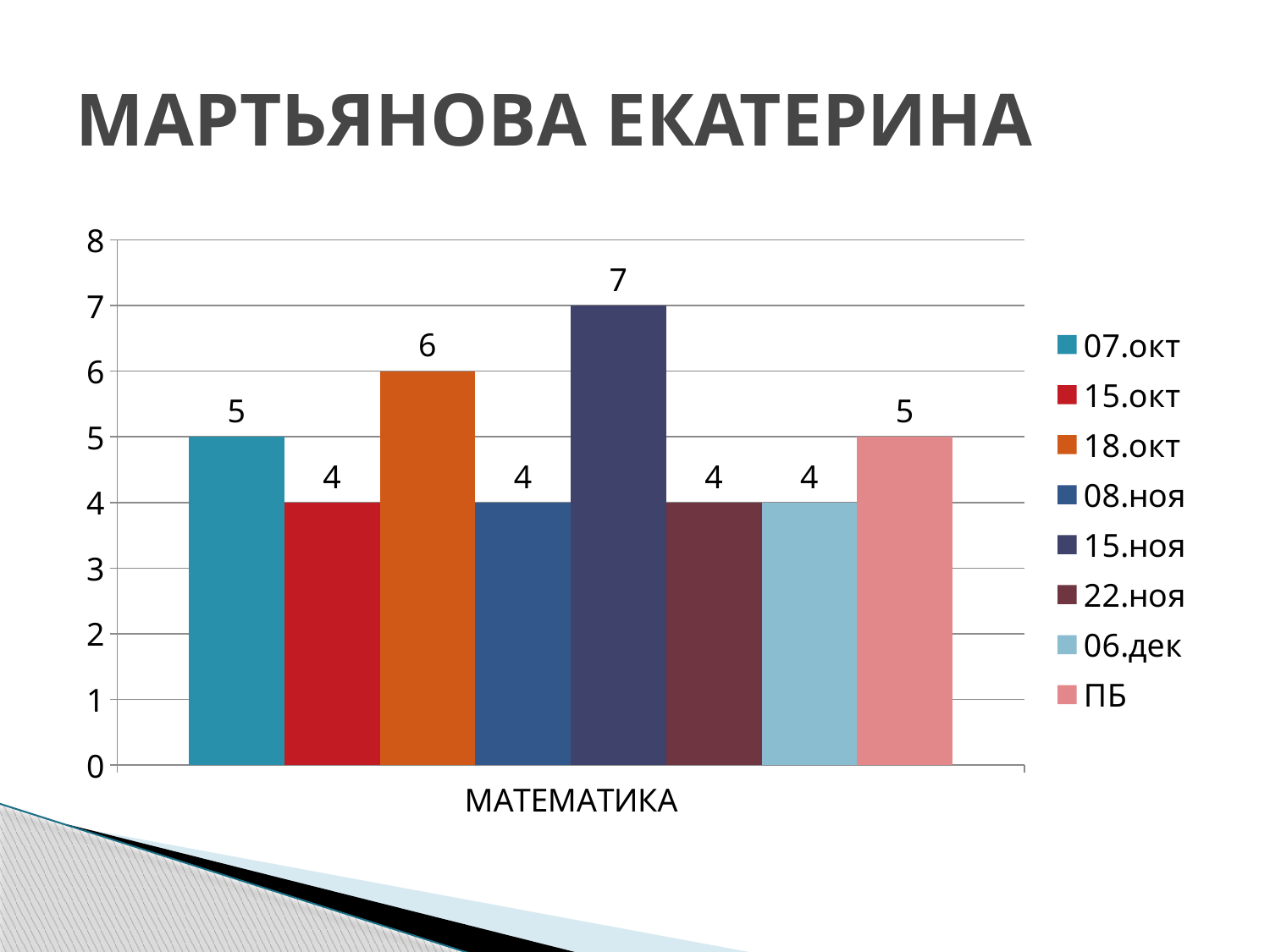
What is the difference between the 15.ноя value and the 18.окт value? 1 What is the difference between the 15.ноя value and the 15.окт value? 3 Which series has the highest value? 15.ноя How many series does the legend list? 8 Which is larger, the value for 07.окт or the value for 18.окт? 18.окт How many series have a value of 4? 4 What is the category label shown on the x axis? МАТЕМАТИКА What is the value for the 18.окт series? 6 What is the value for the ПБ series? 5 What is the value for the 07.окт series in the МАТЕМАТИКА category? 5 What is the value for the 15.ноя series? 7 What kind of chart is shown on the slide? bar chart